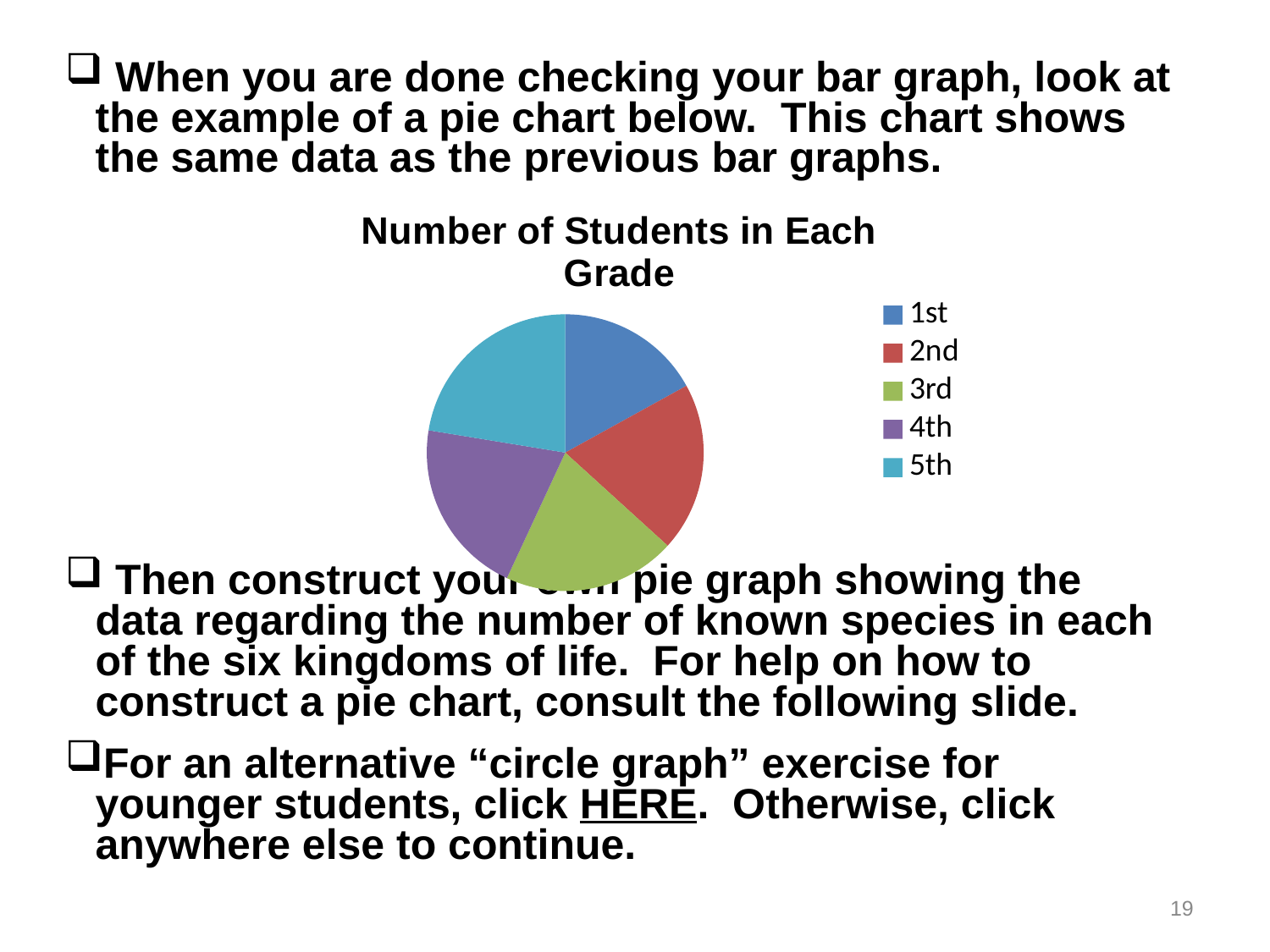
How many entries does the legend of the pie chart list? 5 What kind of chart is shown on the slide? pie chart Which grade is represented by the red slice in the pie chart? 2nd What is the title of the pie chart? Number of Students in Each Grade How many slices does the pie chart have? 5 Which grade has the smallest slice in the pie chart? 1st Which slice is larger in the pie chart, 1st or 5th? 5th